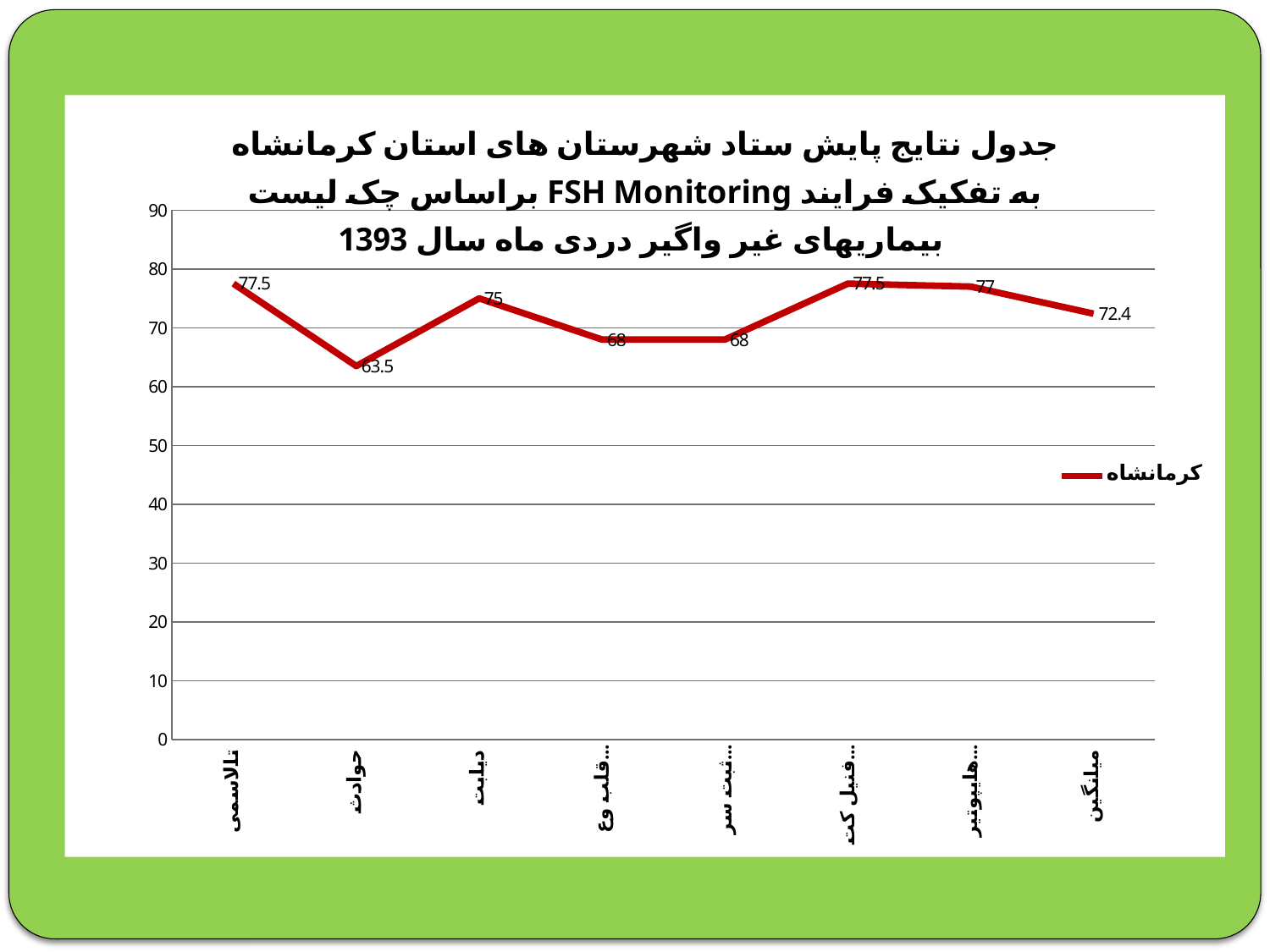
Is the value for حوادث greater or less than 70? less What is the value for دیابت? 75 How many categories are shown on the x axis? 8 What is the value for تالاسمی? 77.5 What is the value for میانگین? 72.4 What is the value for حوادث? 63.5 How many series does the legend list? 1 What kind of chart is shown on the slide? line chart What is the difference between the values for دیابت and میانگین? 2.6 Which is larger, the value for دیابت or the value for حوادث? دیابت Which category has the lowest value? حوادث What is the difference between the values for تالاسمی and حوادث? 14